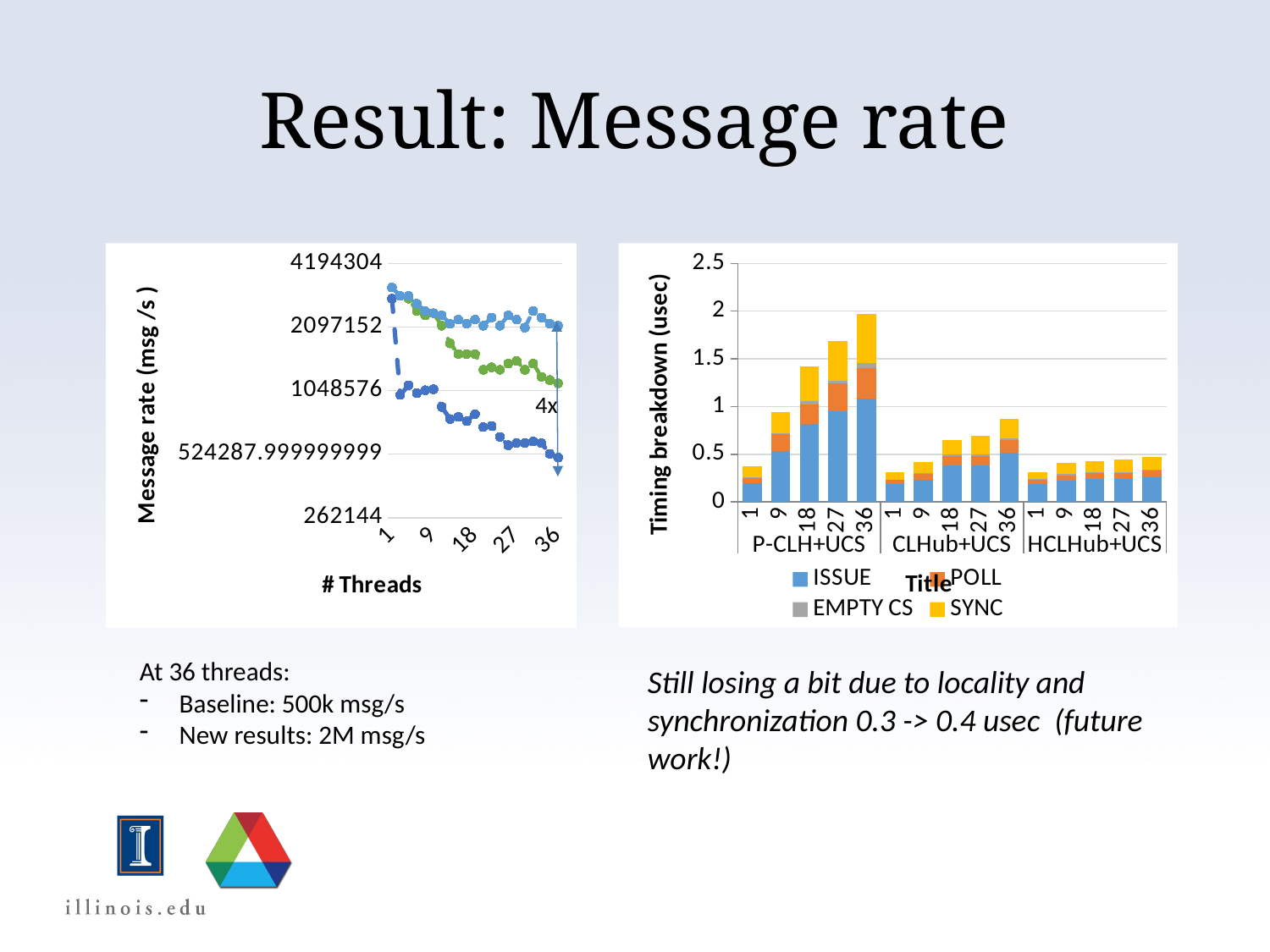
What are the legend entries of the right-hand chart (Timing breakdown)? ISSUE, POLL, EMPTY CS, SYNC What is the x-axis title of the left-hand chart (Message rate)? # Threads In the right-hand chart (Timing breakdown), how many bars are plotted in total? 15 In the right-hand chart (Timing breakdown), is the total for CLHub+UCS at 36 threads greater or less than 1? less In the right-hand chart (Timing breakdown), is the total for P-CLH+UCS at 36 threads greater or less than 1.5? greater In the right-hand chart (Timing breakdown), which is larger at 36 threads: the P-CLH+UCS bar or the HCLHub+UCS bar? P-CLH+UCS How many series does the legend of the right-hand chart (Timing breakdown) list? 4 In the right-hand chart (Timing breakdown), do the bars for P-CLH+UCS rise or fall as the thread count increases from 1 to 36? rise In the left-hand chart (Message rate), how many tick labels are shown on the x axis? 5 What kind of chart is the right-hand chart (Timing breakdown)? Stacked bar chart In the right-hand chart (Timing breakdown), which group contains the tallest bar? P-CLH+UCS In the right-hand chart (Timing breakdown), is the total for P-CLH+UCS at 1 thread greater or less than 0.5? less